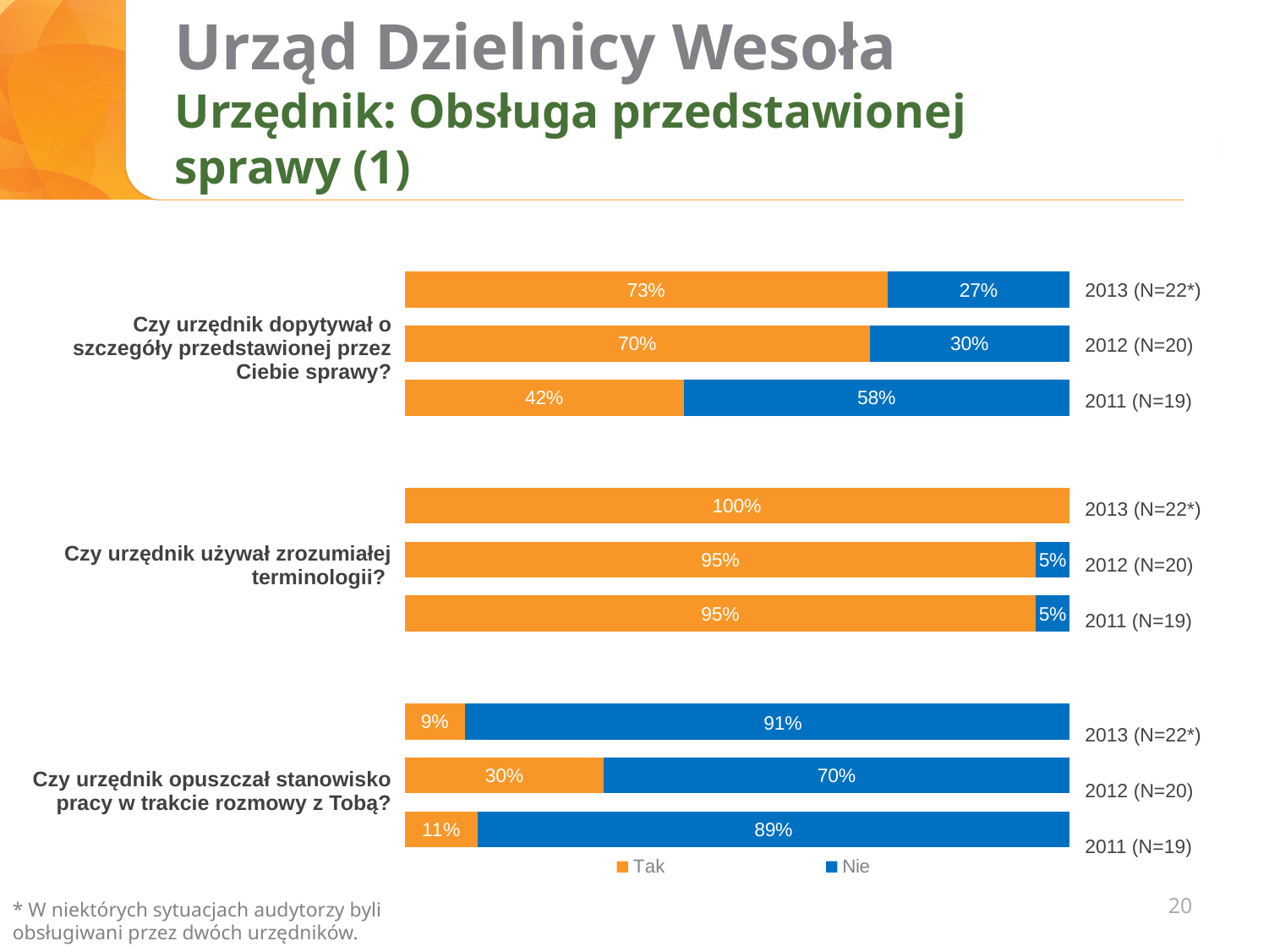
How many series does the legend list? 2 What are the two series named in the legend? Tak and Nie For the question 'Czy urzędnik opuszczał stanowisko pracy w trakcie rozmowy z Tobą?', which year has the lowest 'Tak' share? 2013 (N=22*) For the question 'Czy urzędnik opuszczał stanowisko pracy w trakcie rozmowy z Tobą?', is the 'Tak' value larger in 2012 (N=20) or in 2011 (N=19)? 2012 (N=20) How many bars are plotted on the chart in total? 9 What is the difference between the 'Tak' values for 2013 (N=22*) and 2011 (N=19) for the question 'Czy urzędnik dopytywał o szczegóły przedstawionej przez Ciebie sprawy?'? 31 percentage points What is the 'Tak' value for 2013 (N=22*) for the question 'Czy urzędnik używał zrozumiałej terminologii?'? 100% What is the 'Tak' value for 2013 (N=22*) for the question 'Czy urzędnik dopytywał o szczegóły przedstawionej przez Ciebie sprawy?'? 73% What is the 'Nie' value for 2012 (N=20) for the question 'Czy urzędnik opuszczał stanowisko pracy w trakcie rozmowy z Tobą?'? 70% For the question 'Czy urzędnik dopytywał o szczegóły przedstawionej przez Ciebie sprawy?', which year has the highest 'Tak' share? 2013 (N=22*) What type of chart is shown on the slide? stacked bar chart What is the 'Nie' value for 2011 (N=19) for the question 'Czy urzędnik dopytywał o szczegóły przedstawionej przez Ciebie sprawy?'? 58%